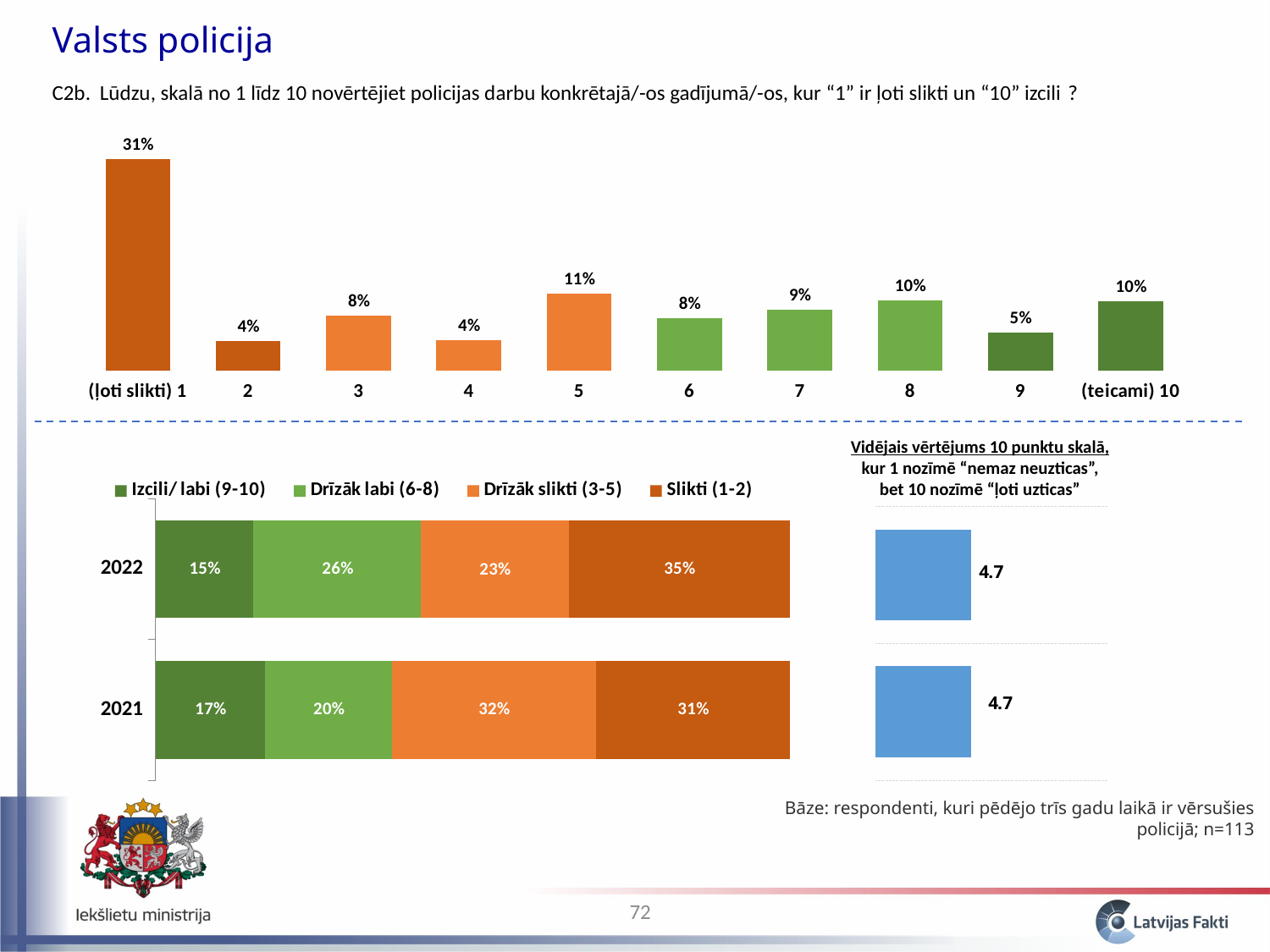
In the top bar chart, which is larger, the value for rating 7 or the value for rating 9? Rating 7 In the bottom-left stacked bar chart, what is the value of 'Drīzāk slikti (3-5)' for 2021? 32% In the top bar chart, what percentage of respondents gave a rating of 1 (ļoti slikti)? 31% In the top bar chart, what is the value for rating 5? 11% In the bottom-right chart (Vidējais vērtējums 10 punktu skalā), what is the average rating for 2022? 4.7 How many series does the legend of the bottom-left stacked bar chart list? 4 In the bottom-left stacked bar chart, what is the difference between the 'Drīzāk labi (6-8)' values for 2022 and 2021? 6% In the top bar chart, what is the difference between the value for rating 1 and the value for rating 10 (teicami)? 21% What kind of chart is the top chart on the slide? Bar chart In the bottom-left stacked bar chart, what is the value of 'Slikti (1-2)' for 2022? 35% In the top bar chart, which rating has the highest percentage? (ļoti slikti) 1 In the top bar chart, how many rating categories are shown on the x axis? 10